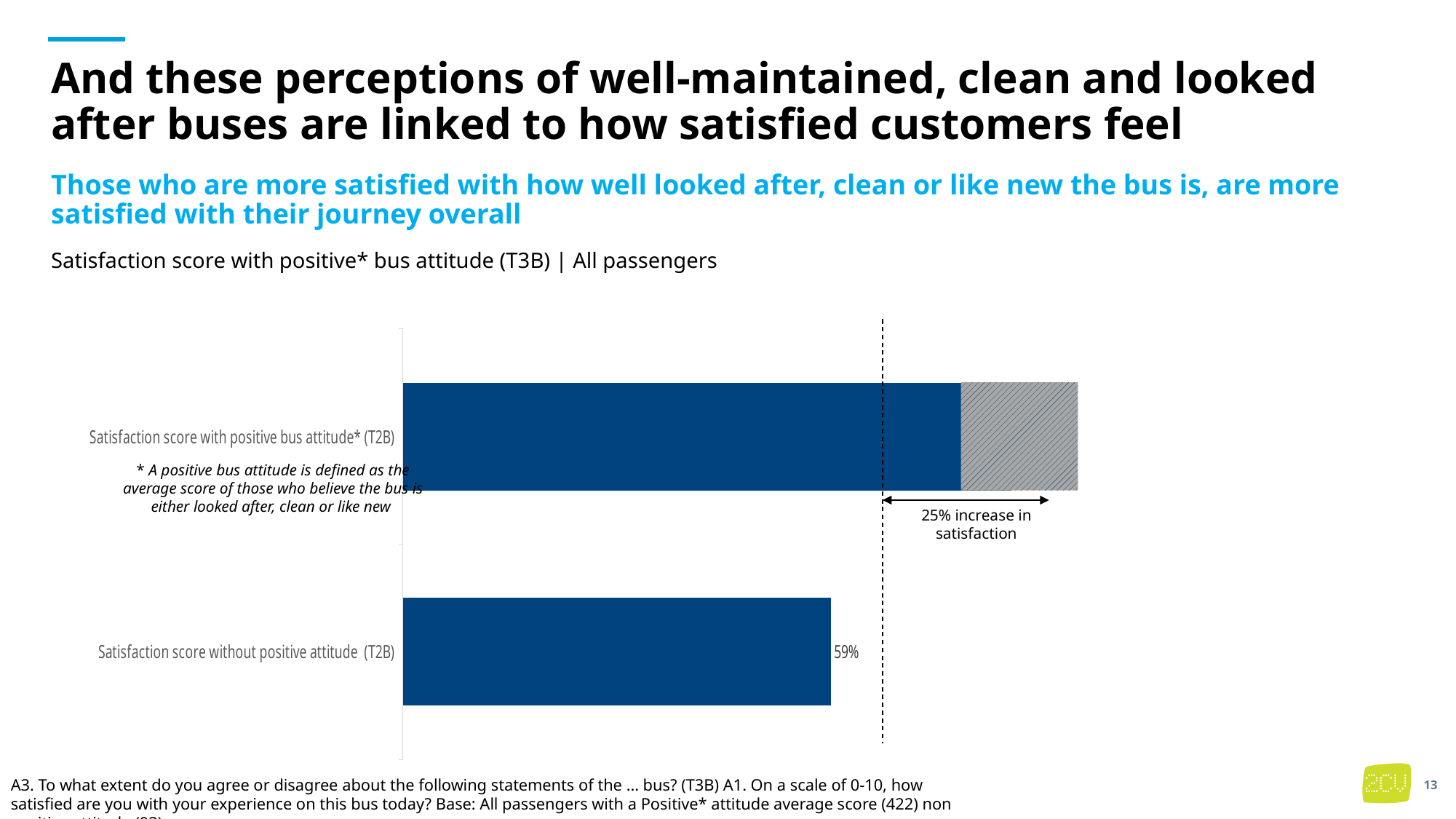
What kind of chart is shown on the slide? Bar chart What increase in satisfaction does the annotation next to the dashed line state? 25% increase in satisfaction What is the title of the chart? Satisfaction score with positive* bus attitude (T3B) | All passengers Which category has the shortest bar? Satisfaction score without positive attitude (T2B) Which category has the longest bar? Satisfaction score with positive bus attitude* (T2B) What is the value for 'Satisfaction score without positive attitude (T2B)'? 59% How many categories are plotted in the chart? 2 Which is larger: the bar for 'Satisfaction score with positive bus attitude* (T2B)' or the bar for 'Satisfaction score without positive attitude (T2B)'? Satisfaction score with positive bus attitude* (T2B)